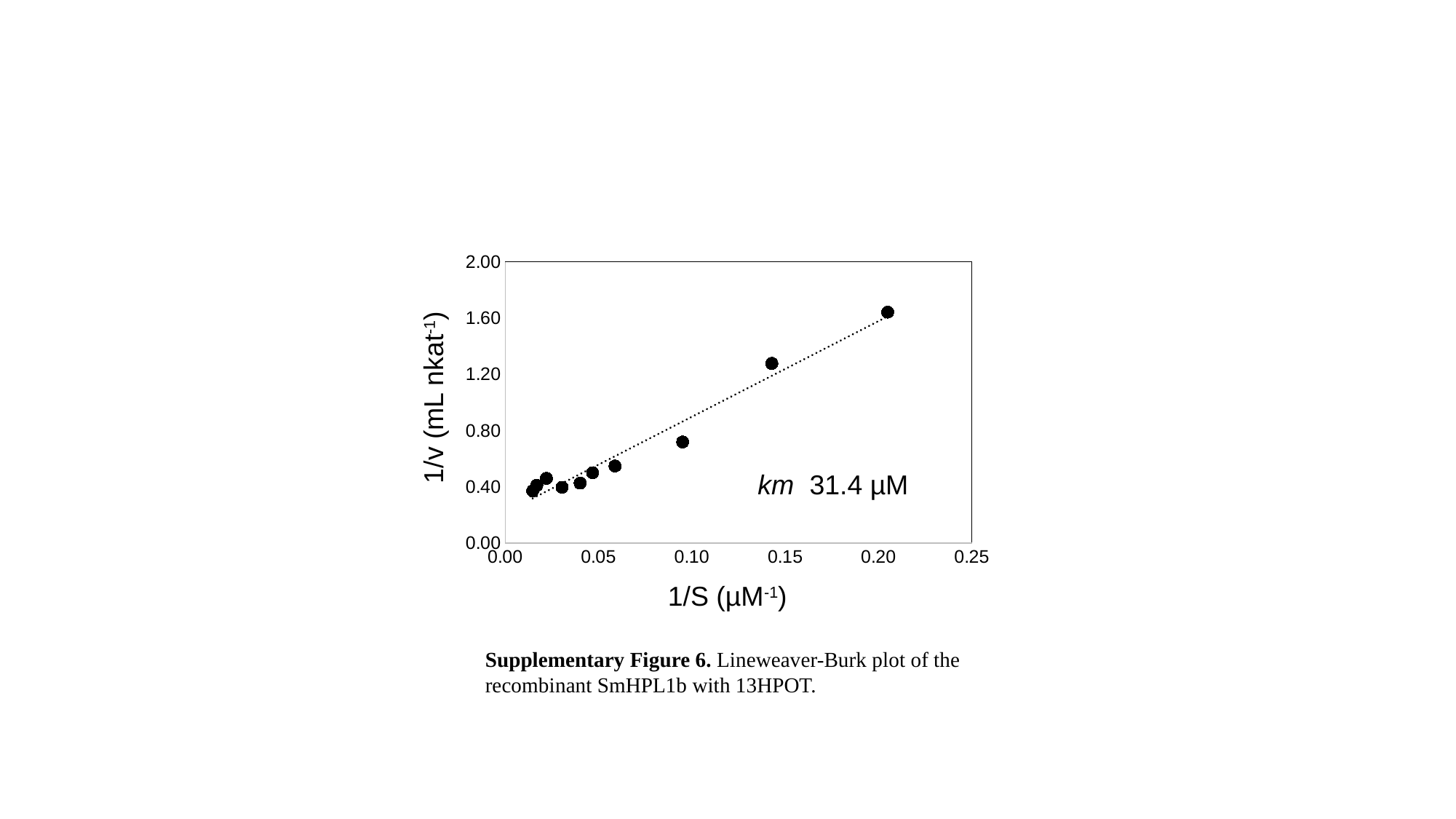
Is the 1/v value of the rightmost data point (near 1/S = 0.20) greater or less than 1.20? greater Do the 1/v values rise or fall as 1/S increases along the x axis? rise Which data point has the highest 1/v value: the one near 1/S = 0.14 or the one near 1/S = 0.20? the one near 1/S = 0.20 Is the 1/v value of the data point near 1/S = 0.14 greater or less than 0.80? greater What kind of chart is shown on the slide? scatter plot Is the 1/v value of the data point near 1/S = 0.095 greater or less than 0.80? less What is the label of the x axis? 1/S (µM-1) What Km value is printed on the chart? 31.4 µM